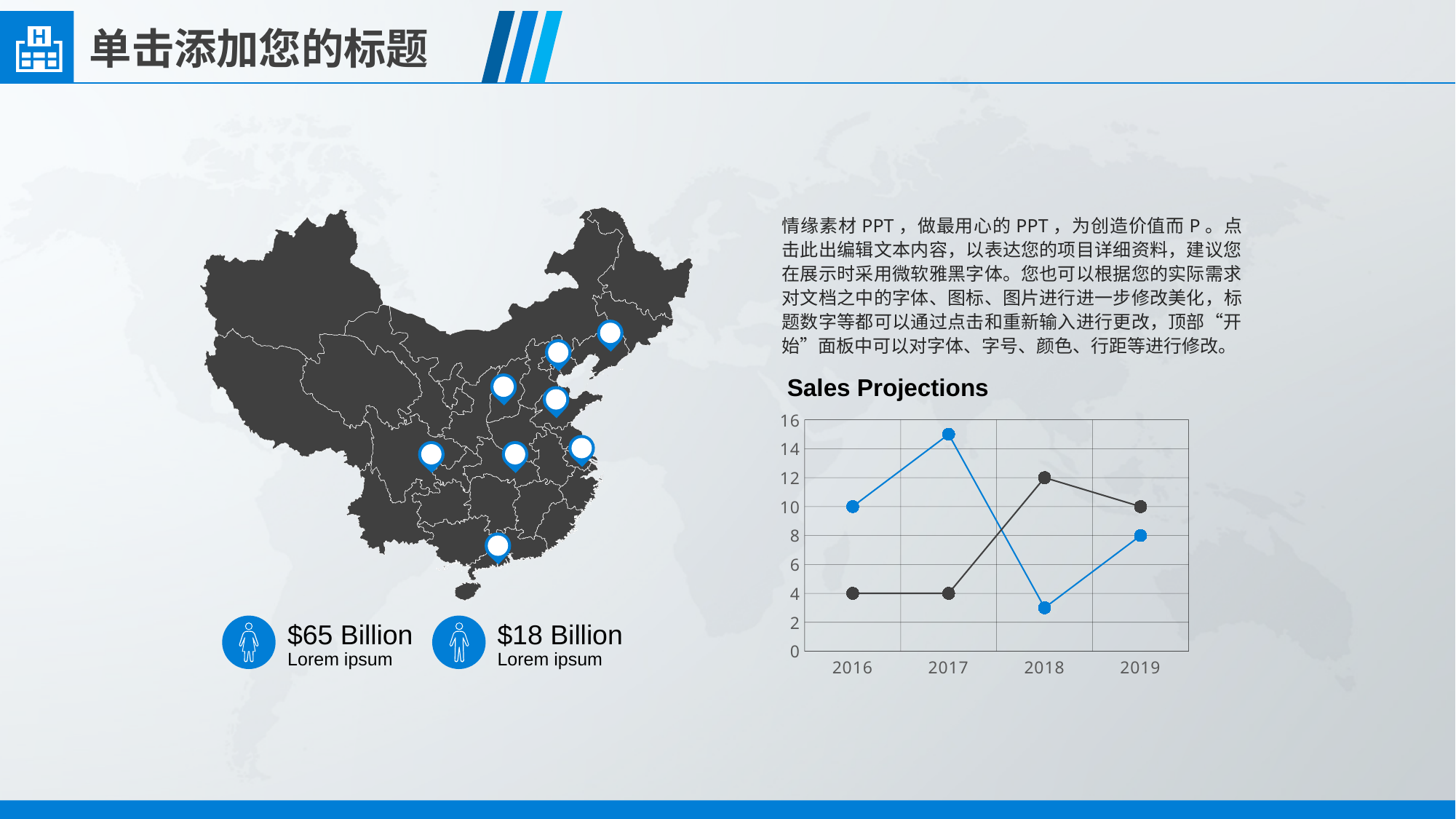
How many lines are plotted in the Sales Projections chart? 2 In the Sales Projections chart, in which year does the blue line reach its highest value? 2017 What kind of chart is the Sales Projections chart? line chart In the Sales Projections chart, in which year is the blue line at its lowest? 2018 In the Sales Projections chart, what is the value of the dark grey line in 2018? 12 In the Sales Projections chart, which line has the higher value in 2018, the blue line or the dark grey line? the dark grey line How many years are shown on the x axis of the Sales Projections chart? 4 In the Sales Projections chart, what is the value of the blue line in 2019? 8 In the Sales Projections chart, is the value of the blue line in 2017 greater or less than 14? greater In the Sales Projections chart, what is the value of the blue line in 2016? 10 In the Sales Projections chart, what is the value of the dark grey line in 2016? 4 In the Sales Projections chart, by how much does the dark grey line increase from 2016 to 2018? 8